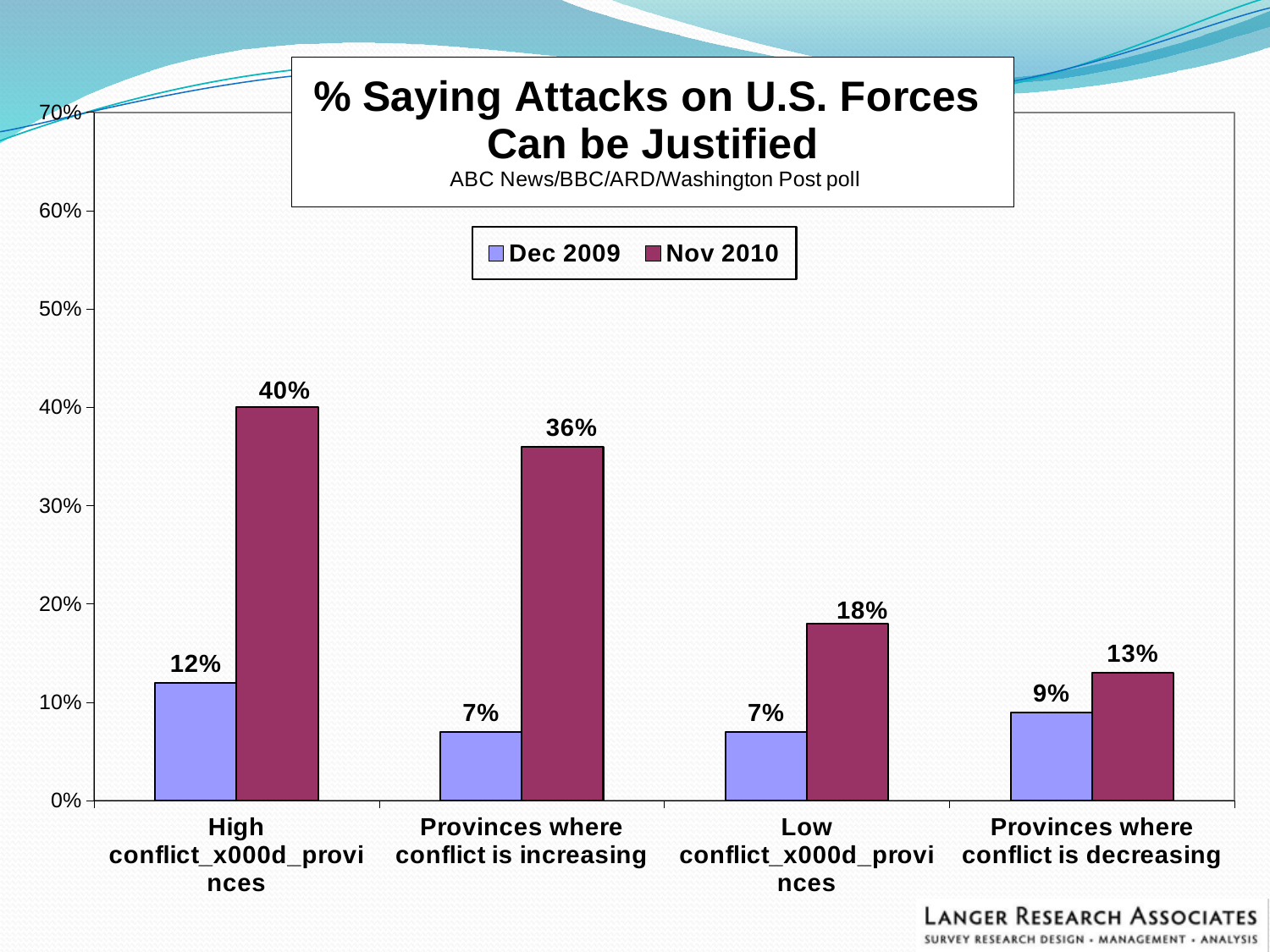
How many series does the legend list? 2 What kind of chart is shown on the slide? Bar chart What is the Dec 2009 value for Provinces where conflict is increasing? 7% Which category has the highest Nov 2010 value? High conflict provinces Which poll is cited under the chart title? ABC News/BBC/ARD/Washington Post poll What is the difference between the Nov 2010 and Dec 2009 values for High conflict provinces? 28% What is the difference between the Nov 2010 values for Provinces where conflict is increasing and Low conflict provinces? 18% How many categories are shown on the x axis? 4 Which category has the lowest Nov 2010 value? Provinces where conflict is decreasing What is the Nov 2010 value for High conflict provinces? 40% Which is larger: the Dec 2009 value for High conflict provinces or the Dec 2009 value for Provinces where conflict is decreasing? High conflict provinces What is the Nov 2010 value for Provinces where conflict is decreasing? 13%